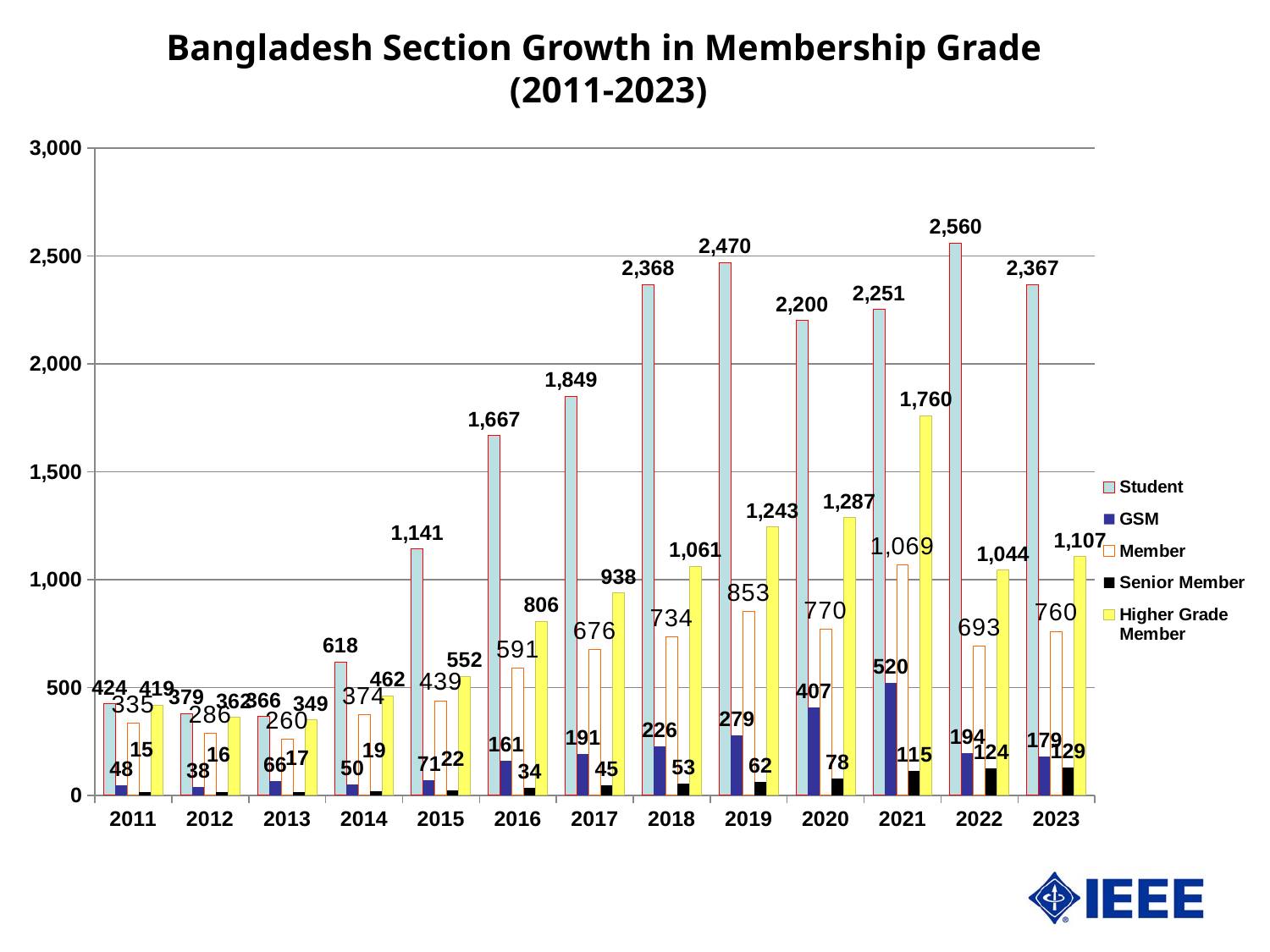
What is the title of the chart? Bangladesh Section Growth in Membership Grade (2011-2023) Which is larger in 2021, Member or Higher Grade Member? Higher Grade Member How many series does the legend list? 5 What kind of chart is shown on the slide? bar chart What is the value for Student in 2022? 2,560 In which year is the Student value highest? 2022 What is the value for Higher Grade Member in 2019? 1,243 How many years are shown on the x axis? 13 In which year is the Senior Member value lowest? 2011 What is the value for GSM in 2021? 520 Do the Senior Member values rise or fall from 2011 to 2023? rise What is the difference between the Student values for 2019 and 2018? 102